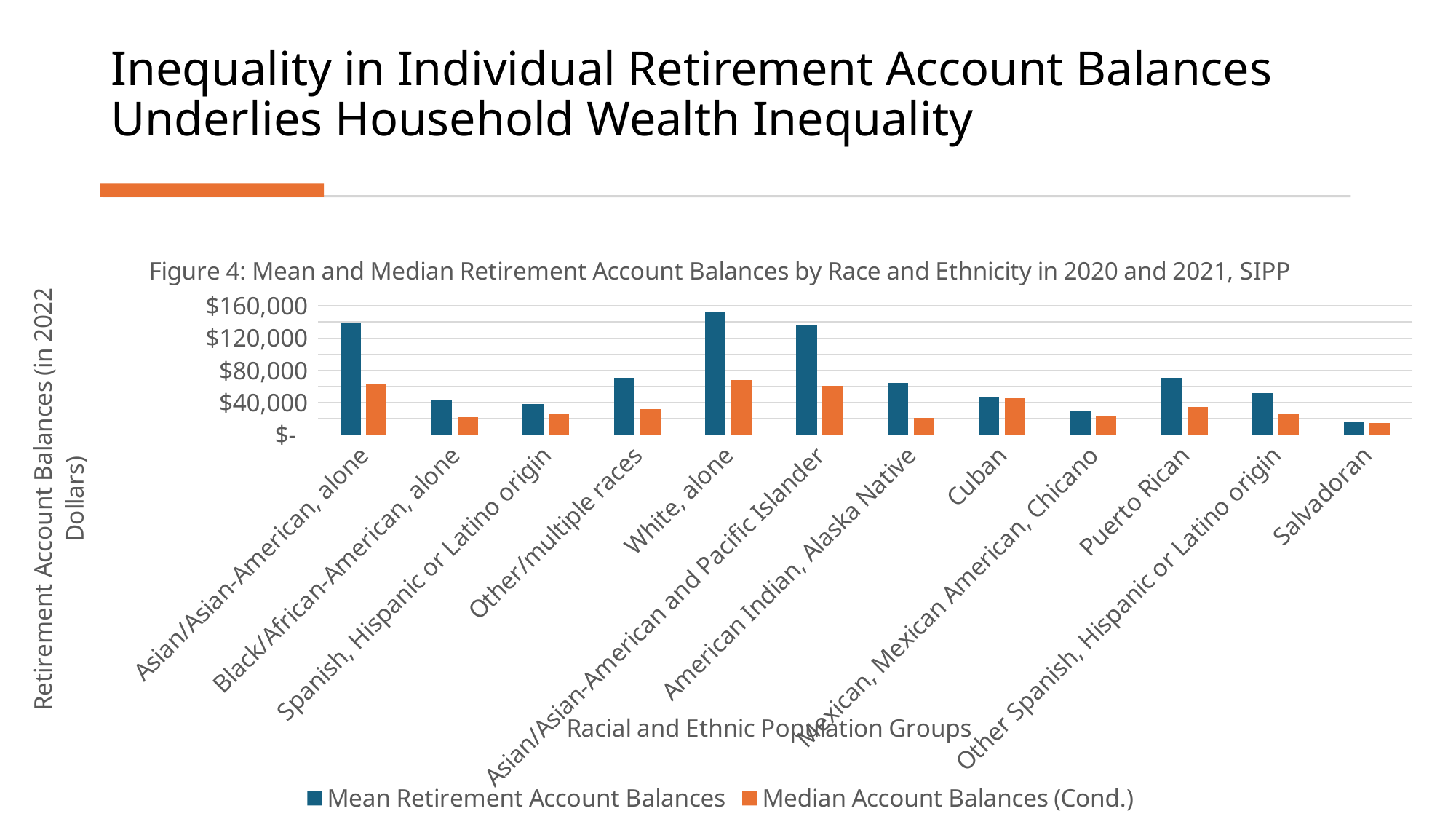
What is the title of the figure shown on the slide? Figure 4: Mean and Median Retirement Account Balances by Race and Ethnicity in 2020 and 2021, SIPP Which group has the lowest Median Account Balance (Cond.)? Salvadoran Is the Mean Retirement Account Balance for White, alone greater or less than $120,000? greater Which group has the lowest Mean Retirement Account Balance? Salvadoran How many series does the legend list? 2 Is the Mean Retirement Account Balance for Salvadoran greater or less than $40,000? less How many racial and ethnic population groups are shown on the x axis? 12 Is the Median Account Balance (Cond.) for Cuban greater or less than $40,000? greater Which is larger: the Mean Retirement Account Balance for White, alone or for Black/African-American, alone? White, alone Which group has the highest Mean Retirement Account Balance? White, alone What kind of chart is shown on the slide? Bar chart